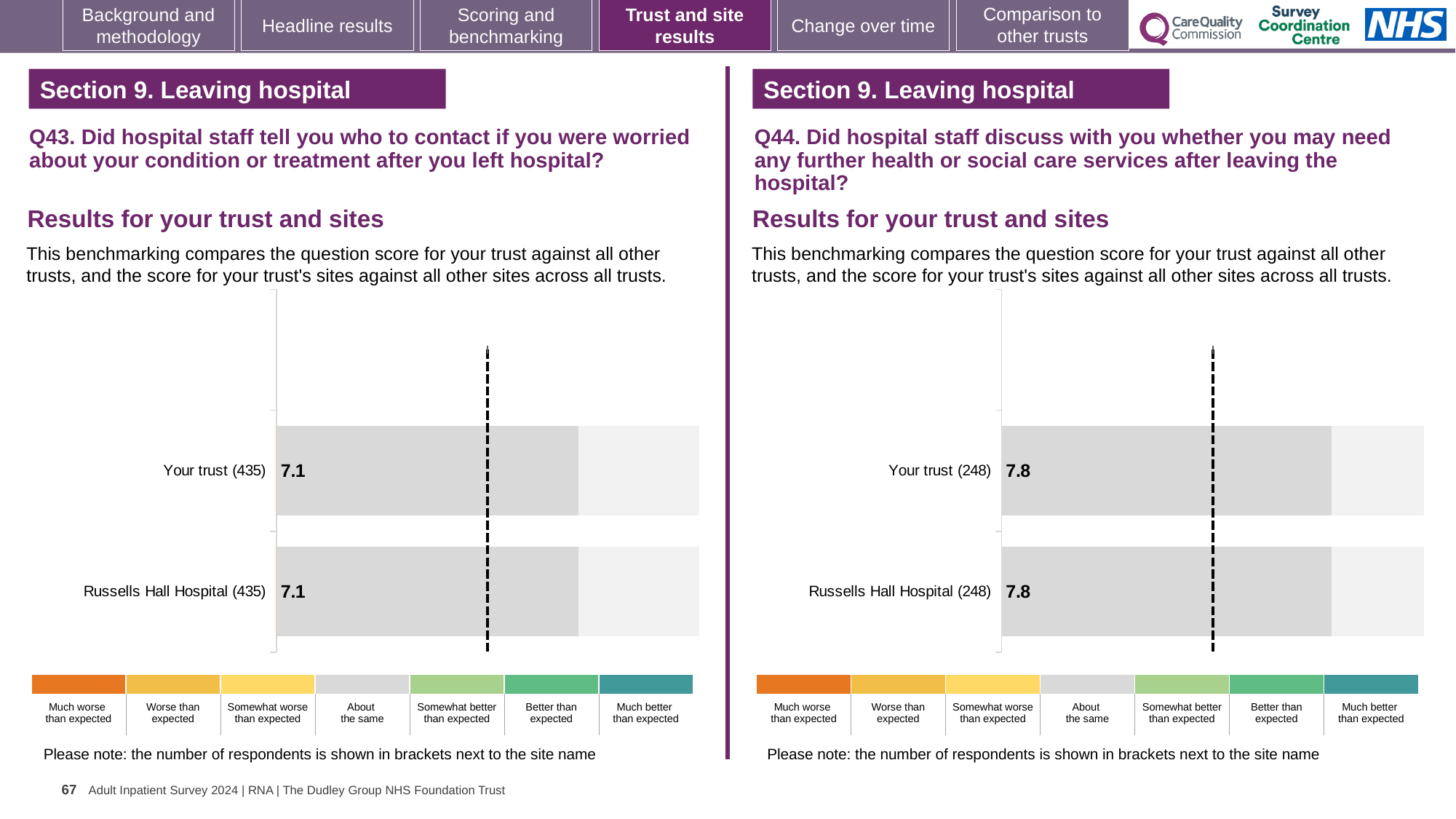
What kind of chart is used on the left (Q43)? Bar chart On the right chart (Q44), how many respondents are shown in brackets next to Russells Hall Hospital? 248 On the left chart (Q43), what is the score for Your trust? 7.1 On the left chart (Q43), how many respondents are shown in brackets next to Your trust? 435 On the left chart (Q43), what is the score for Russells Hall Hospital? 7.1 How many bars are plotted on the right chart (Q44)? 2 Is the score for Your trust on the right chart (Q44) larger or smaller than the score for Your trust on the left chart (Q43)? Larger On the left chart (Q43), what is the difference between the scores for Your trust and Russells Hall Hospital? 0 How many bars are plotted on the left chart (Q43)? 2 On the right chart (Q44), what is the score for Your trust? 7.8 On the right chart (Q44), what is the score for Russells Hall Hospital? 7.8 On the right chart (Q44), what is the difference between the scores for Your trust and Russells Hall Hospital? 0